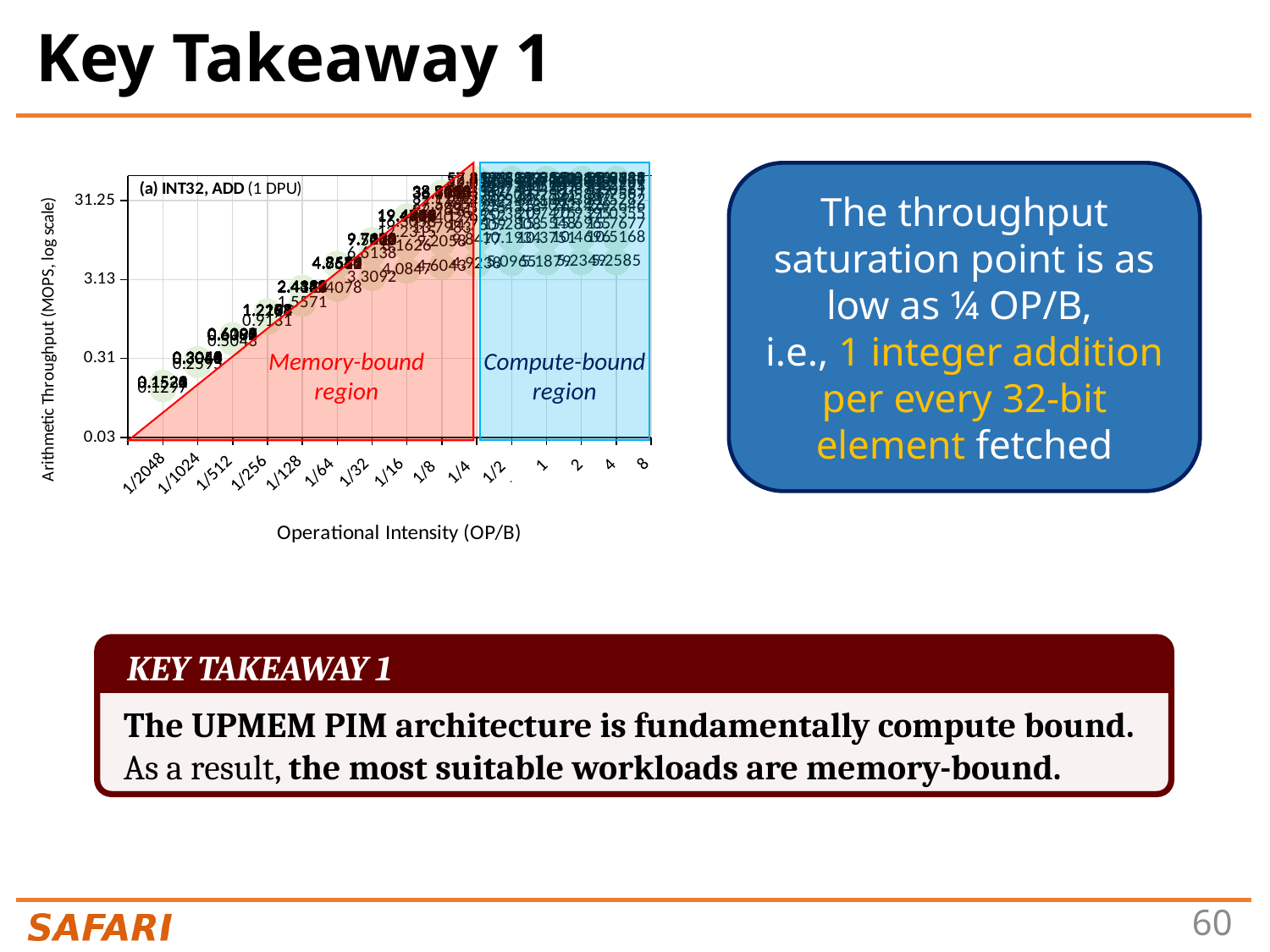
Is the arithmetic throughput at an operational intensity of 1/128 greater or less than 0.31 MOPS? greater Is the arithmetic throughput at an operational intensity of 1/4 greater or less than 3.13 MOPS? greater What is the label of the x axis of the chart? Operational Intensity (OP/B) How does arithmetic throughput change as operational intensity increases from 1/2048 to 1/4? it rises Does arithmetic throughput keep rising or stay flat as operational intensity increases from 1/2 to 8? stays flat What kind of chart is shown on the slide? scatter chart Which has the higher arithmetic throughput: operational intensity 1/2048 or operational intensity 8? 8 Is the arithmetic throughput at an operational intensity of 8 greater or less than 3.13 MOPS? greater What is the title printed inside the chart? (a) INT32, ADD (1 DPU) At which operational intensity is the arithmetic throughput lowest? 1/2048 How many operational intensity values are marked on the x axis of the chart? 15